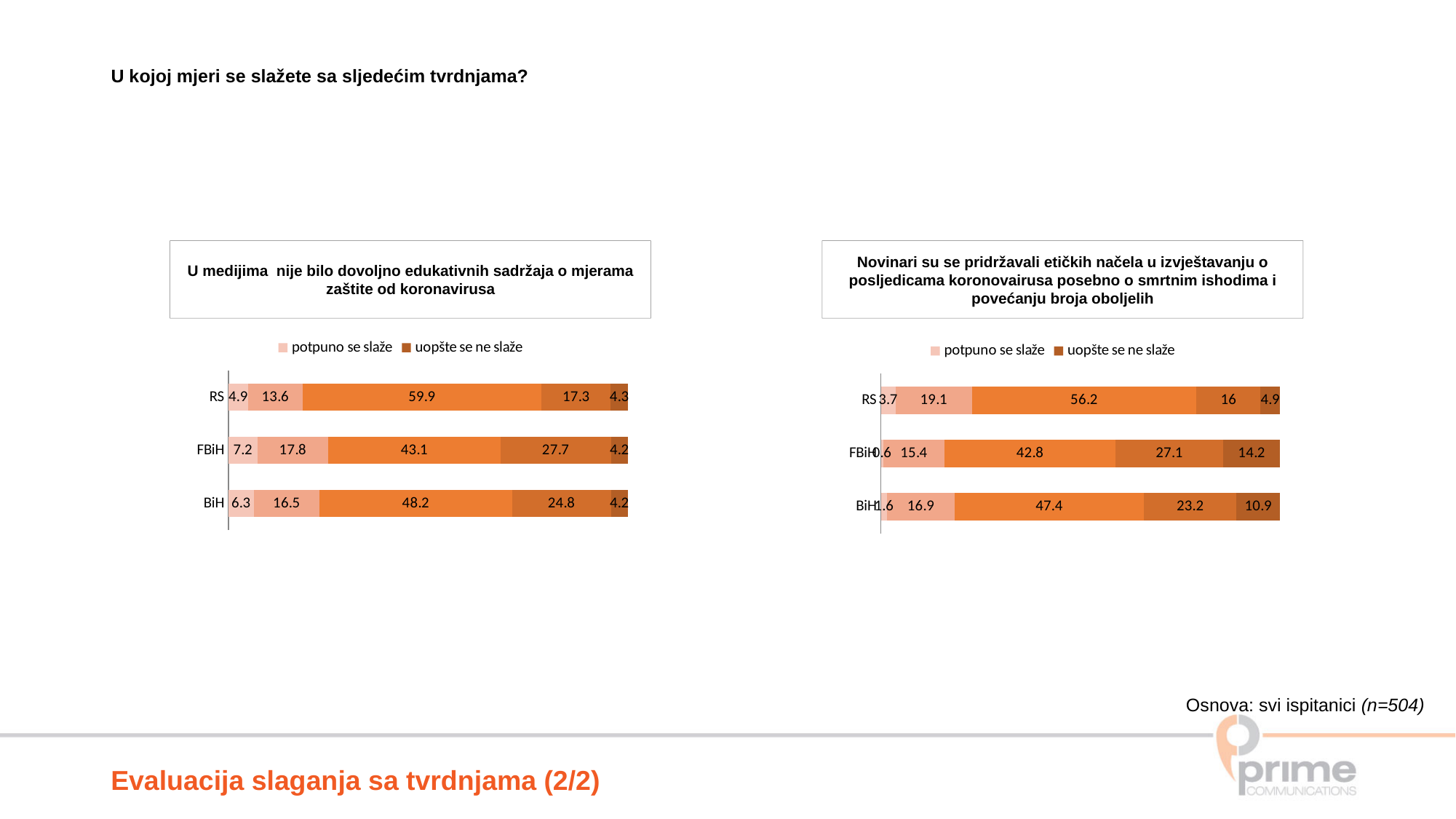
In the right chart, what is the difference between the 'uopšte se ne slaže' values for FBiH and RS? 9.3 In the right chart, which category has the lowest 'potpuno se slaže' value? FBiH What are the two legend entries shown in the left chart? potpuno se slaže; uopšte se ne slaže What type of chart is the left chart? Stacked bar chart In the left chart, what is the total of all segments in the RS bar? 100 In the left chart (U medijima nije bilo dovoljno edukativnih sadržaja...), what is the value of the 'potpuno se slaže' segment for RS? 4.9 How many series does the legend of the right chart list? 2 How many categories are shown in the left chart? 3 In the left chart, what is the value of the largest middle segment for RS? 59.9 In the right chart (Novinari su se pridržavali etičkih načela...), what is the value of the 'uopšte se ne slaže' segment for FBiH? 14.2 In the left chart, which is larger: the 'potpuno se slaže' value for FBiH or for BiH? FBiH In the right chart, which category has the highest 'uopšte se ne slaže' value? FBiH